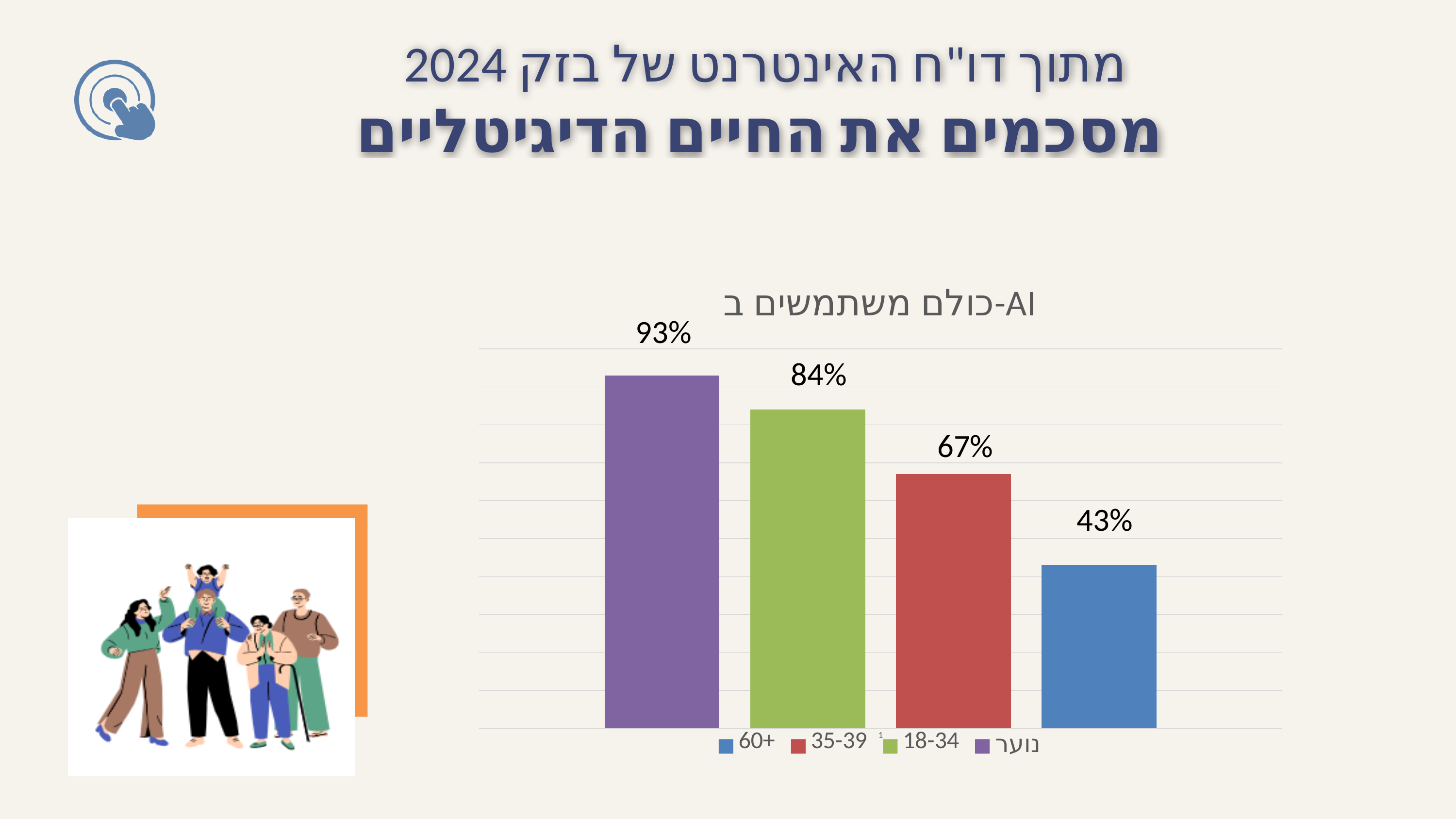
Which group has the lowest value in the chart? 60+ What kind of chart is shown on the slide? Bar chart What is the title of the chart? כולם משתמשים ב-AI What value is shown for the נוער (youth) bar? 93% How many entries does the chart legend list? 4 What value is shown for the 18-34 group? 84% Which is larger, the value for 18-34 or the value for 35-39? 18-34 Which group has the highest value in the chart? נוער What is the difference between the 18-34 value and the 35-39 value? 17% What is the difference between the נוער value and the 60+ value? 50% What value is shown for the 60+ group? 43% What value is shown for the 35-39 group? 67%